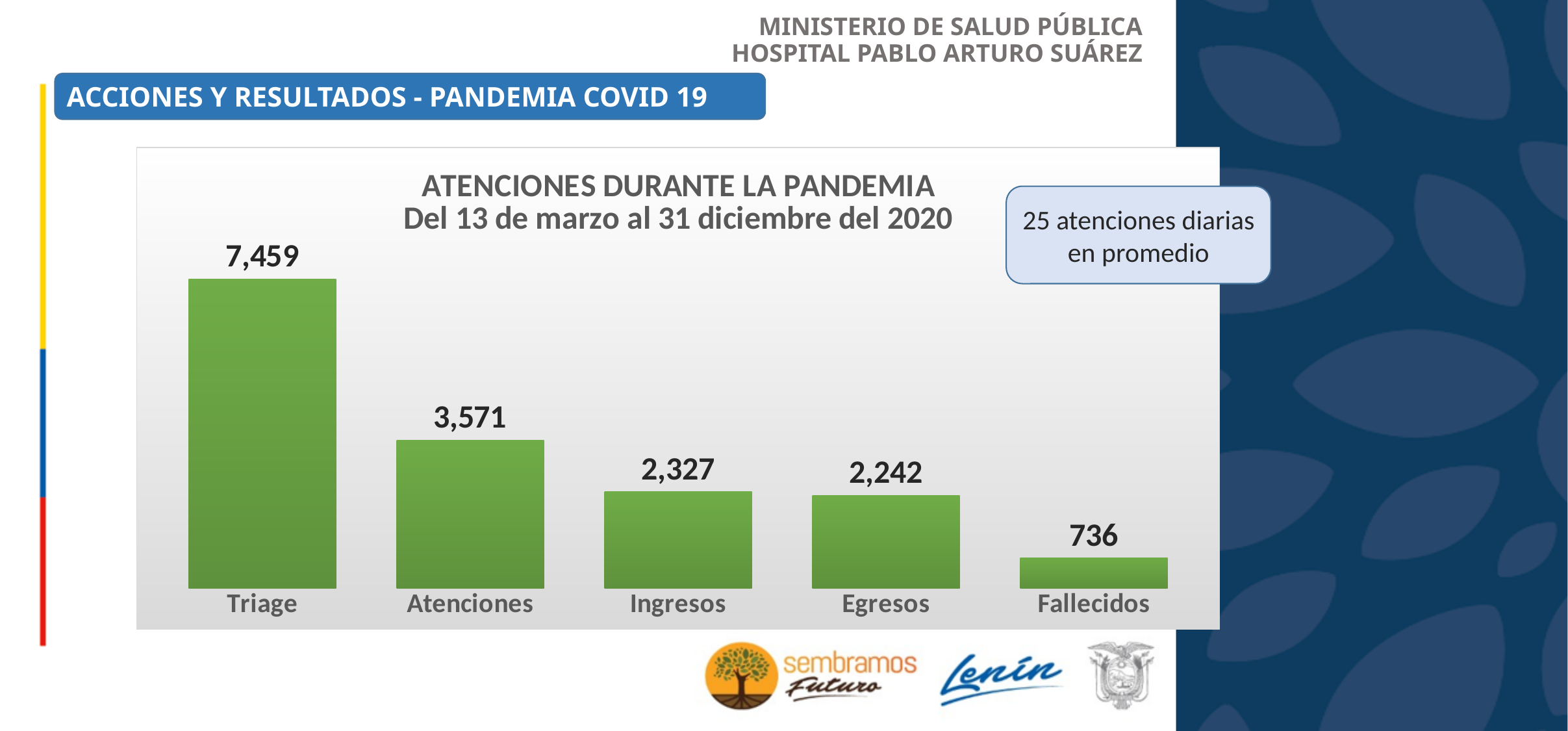
What is the value for Fallecidos? 736 What is the title of the chart? ATENCIONES DURANTE LA PANDEMIA Del 13 de marzo al 31 diciembre del 2020 Which is larger, the value for Atenciones or the value for Egresos? Atenciones How many categories are shown in the chart? 5 What is the value for Ingresos? 2,327 What kind of chart is shown on the slide? Bar chart Which category has the highest value? Triage What is the difference between the values for Triage and Atenciones? 3,888 Which category has the lowest value? Fallecidos What is the value for Atenciones? 3,571 What is the value for Triage? 7,459 What is the difference between the values for Ingresos and Egresos? 85